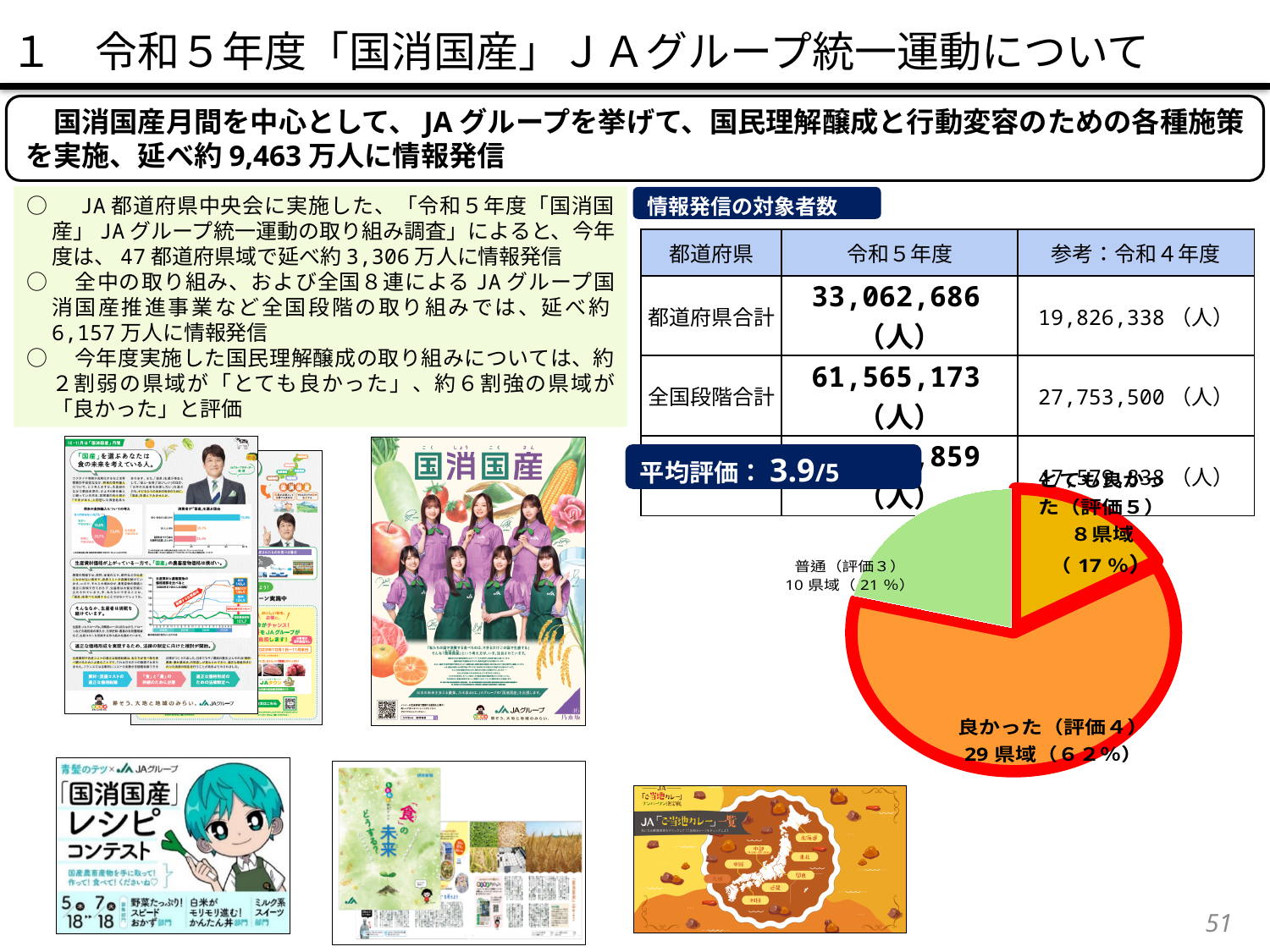
In the pie chart, which slice is larger: 普通（評価3） or とても良かった（評価5）? 普通（評価3） What kind of chart is shown on the right side of the slide? pie chart In the pie chart, how many prefectural areas gave the rating 良かった（評価4）? 29県域 In the pie chart, what share is shown for とても良かった（評価5）? 17% In the pie chart, what share is shown for 良かった（評価4）? 62% How many slices does the pie chart have? 3 In the pie chart, what share is shown for 普通（評価3）? 21% Which rating category has the largest slice in the pie chart? 良かった（評価4） What average rating is shown in the label next to the pie chart? 3.9/5 What is the difference in the number of prefectural areas between 良かった（評価4） and 普通（評価3） in the pie chart? 19県域 Which rating category has the smallest slice in the pie chart? とても良かった（評価5） In the pie chart, how many prefectural areas gave the rating 普通（評価3）? 10県域